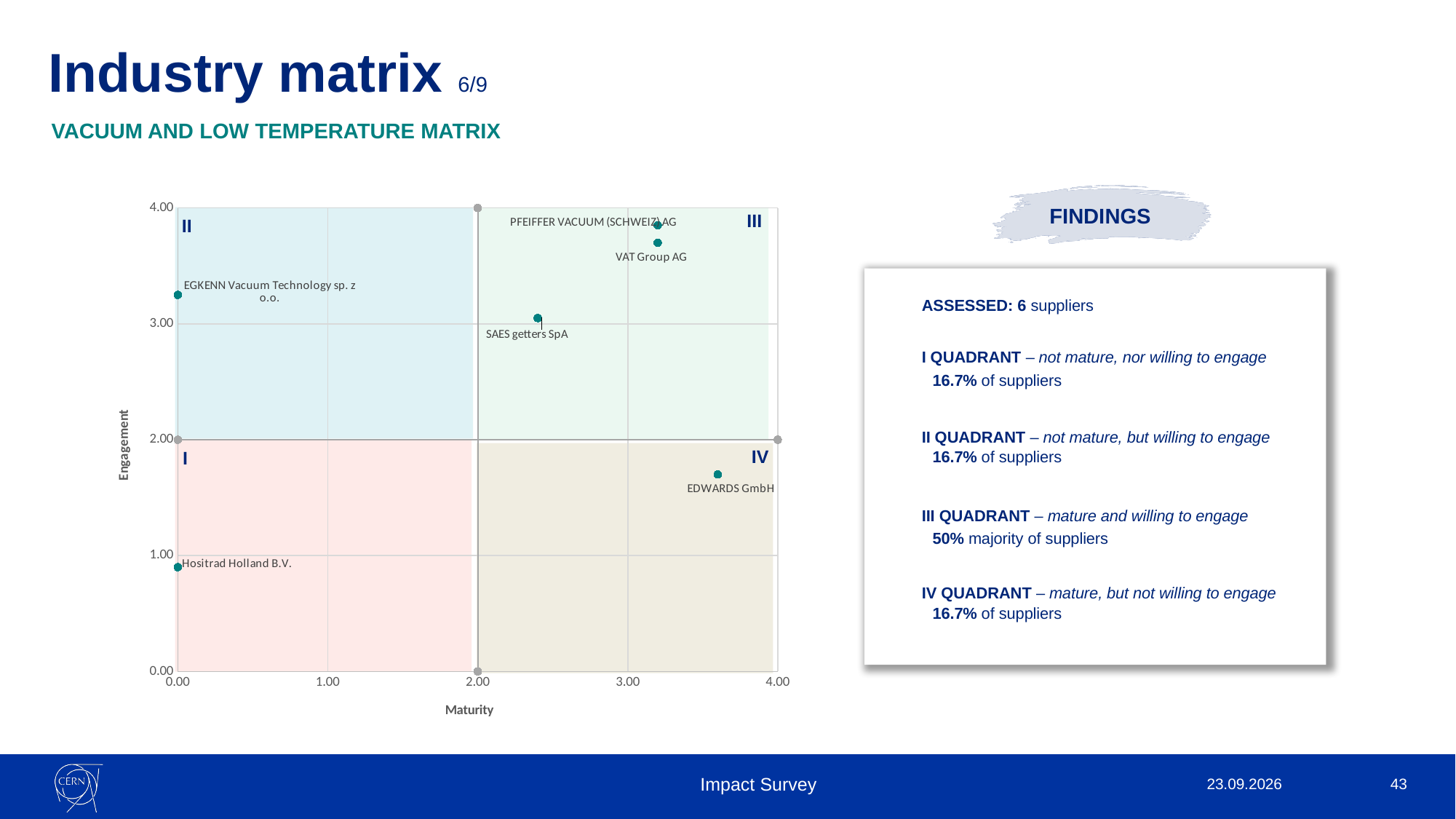
Which supplier has the highest Maturity value on the chart? EDWARDS GmbH Is the Engagement value for EGKENN Vacuum Technology sp. z o.o. greater or less than 3.00? greater Which supplier has the higher Maturity value, EDWARDS GmbH or SAES getters SpA? EDWARDS GmbH How many suppliers are plotted on the chart? 6 Is the Maturity value for SAES getters SpA greater or less than 2.00? greater Which supplier has the lowest Engagement value on the chart? Hositrad Holland B.V. What is the label of the vertical axis of the chart? Engagement Is the Engagement value for EDWARDS GmbH greater or less than 2.00? less Which supplier has the higher Engagement value, VAT Group AG or EDWARDS GmbH? VAT Group AG What is the label of the horizontal axis of the chart? Maturity What kind of chart is shown on the slide? Scatter chart